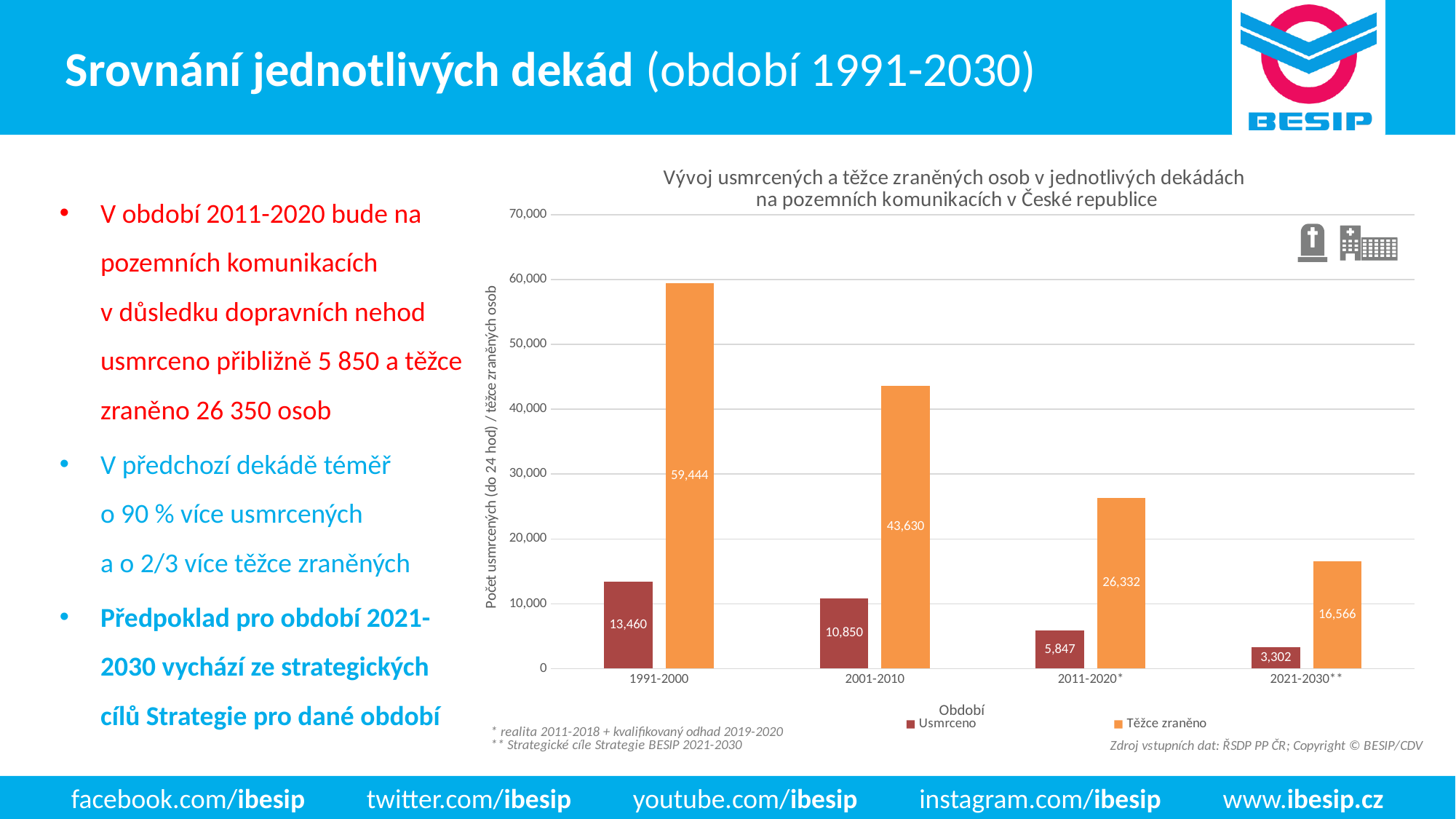
What is the value of Usmrceno for 1991-2000? 13,460 Which period has the highest Těžce zraněno value? 1991-2000 Does the Usmrceno series rise or fall across the periods from 1991-2000 to 2021-2030**? fall How many series does the legend list? 2 What is the difference between the Usmrceno values for 1991-2000 and 2001-2010? 2,610 Is the Těžce zraněno value for 2011-2020* greater or less than 20,000? greater What is the value of Těžce zraněno for 2001-2010? 43,630 What is the difference between the Těžce zraněno values for 2011-2020* and 2021-2030**? 9,766 Which period has the lowest Usmrceno value? 2021-2030** How many periods are shown on the x axis? 4 Which is larger: Usmrceno for 2011-2020* or Usmrceno for 2021-2030**? Usmrceno for 2011-2020* What is the value of Těžce zraněno for 2021-2030**? 16,566